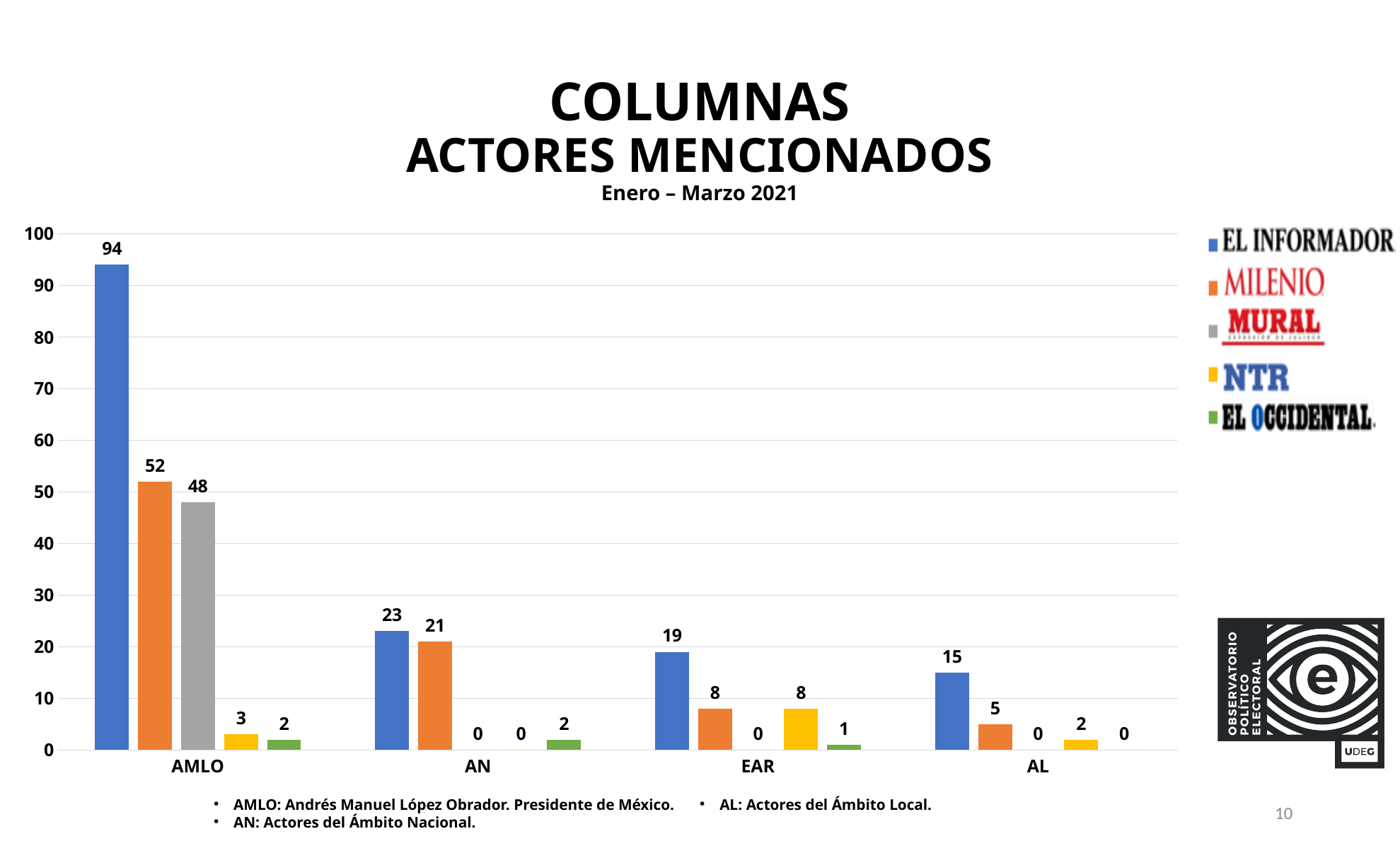
What is the value for Milenio in the AL category? 5 What is the value for NTR in the EAR category? 8 What period does the chart subtitle indicate? Enero – Marzo 2021 What is the difference between the El Informador and Milenio values in the AMLO category? 42 Which category has the lowest value for El Informador? AL Which is larger in the AN category: El Informador or Milenio? El Informador What kind of chart is shown on the slide? Bar chart How many categories are shown on the x axis? 4 Which category has the highest value for El Informador? AMLO What is the value for Mural in the AMLO category? 48 How many series does the legend list? 5 What is the value for El Informador in the AMLO category? 94